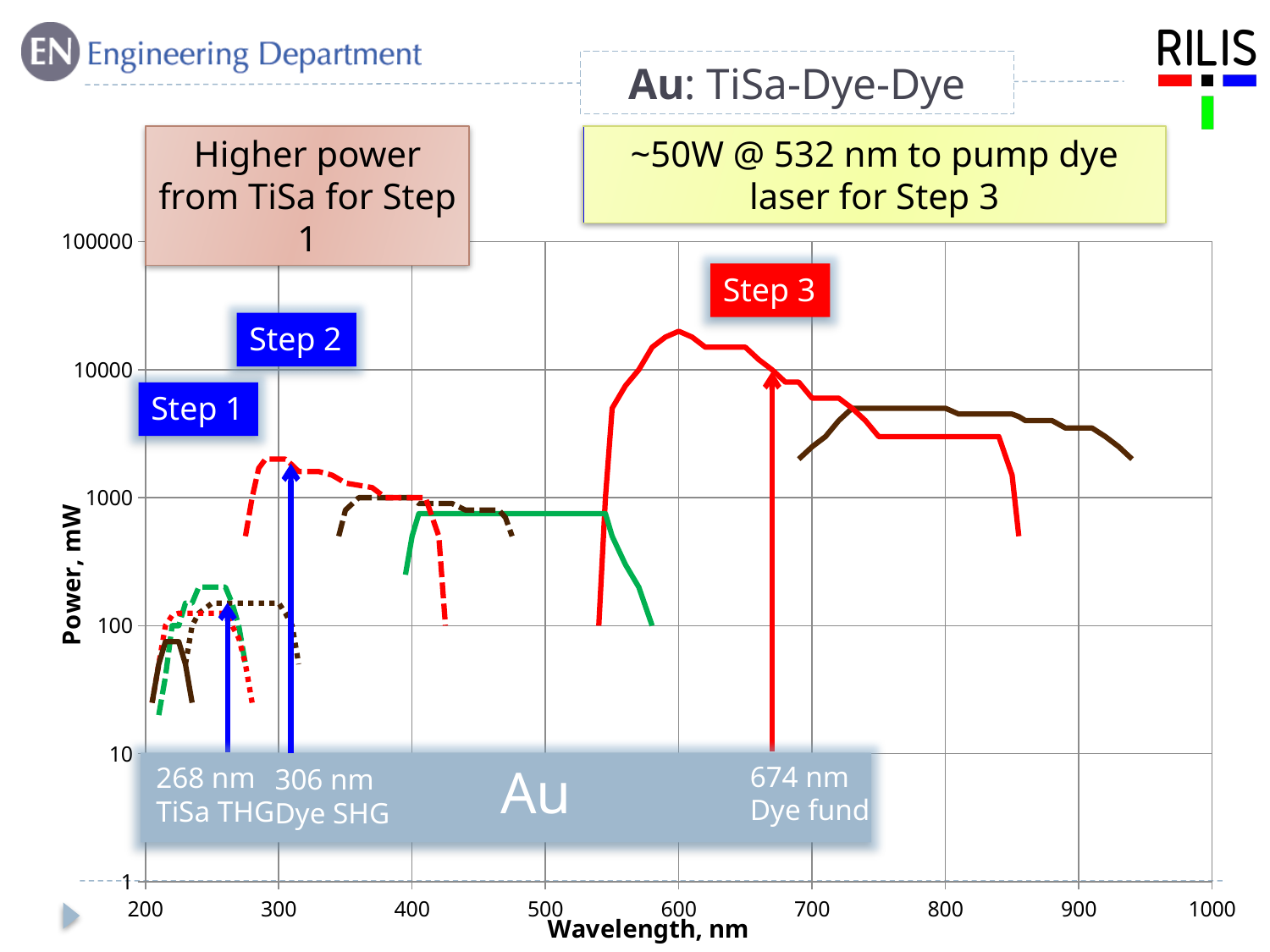
Which step's arrow reaches the highest power on the chart? Step 3 At what wavelength is the Step 1 arrow placed, according to the label on the chart? 268 nm At what wavelength is the Step 3 arrow placed, according to the label on the chart? 674 nm Is the flat part of the solid green curve between 400 nm and 550 nm greater or less than 1000 mW? less At what wavelength is the Step 2 arrow placed, according to the label on the chart? 306 nm What kind of chart is shown on the slide? line chart Is the peak of the solid red curve near 600 nm greater or less than 10000 mW? greater How many excitation steps are labelled on the chart? 3 Which reaches a higher power: the peak of the solid red curve near 600 nm or the peak of the dashed red curve near 300 nm? the solid red curve near 600 nm What is the label of the vertical axis of the chart? Power, mW What is the title of the chart on the slide? Au: TiSa-Dye-Dye Is the solid brown curve at around 800 nm greater or less than 1000 mW? greater